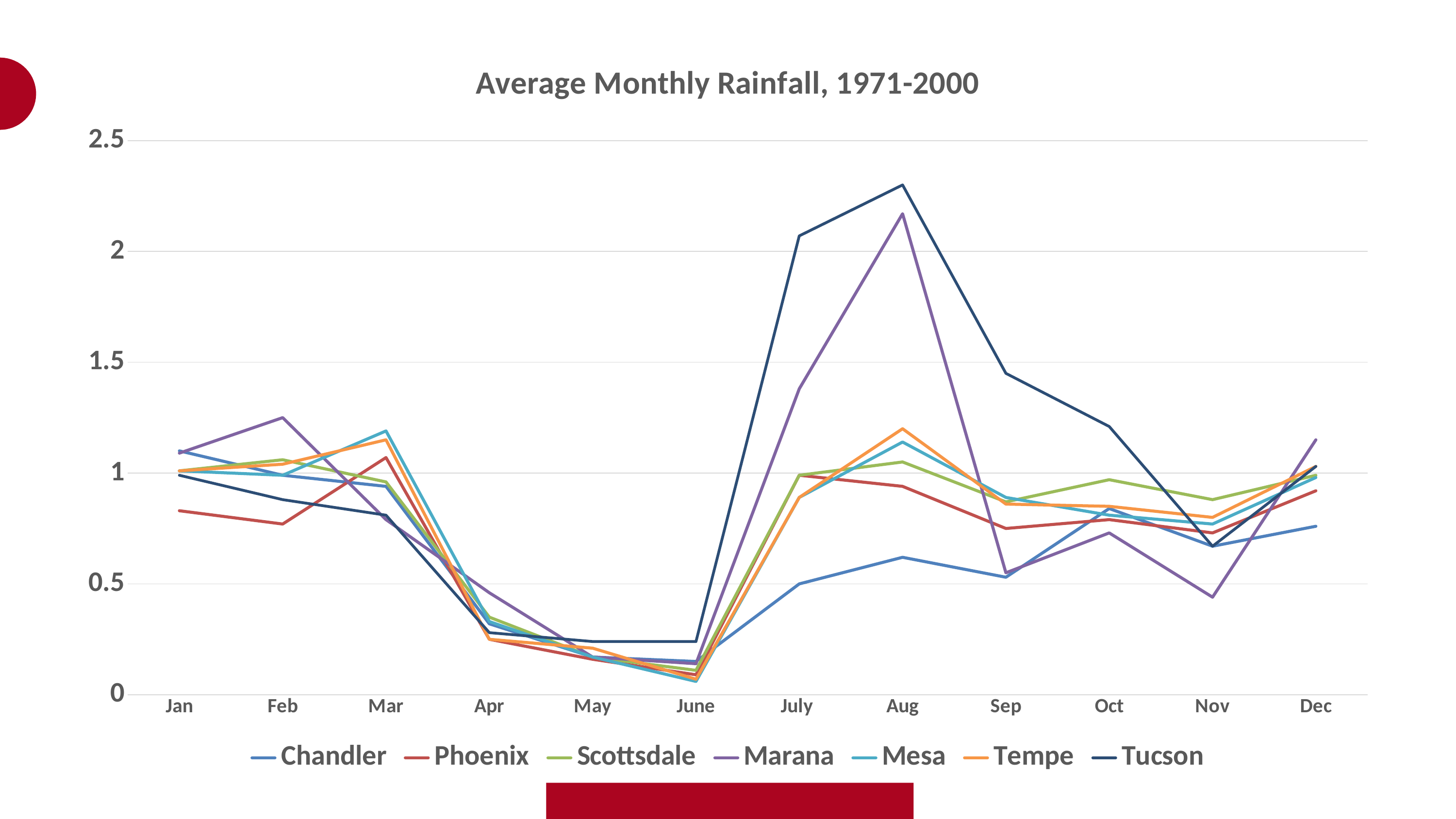
Is the value for Tucson in Aug greater or less than 2? greater Which series has the highest value in Aug? Tucson What kind of chart is shown on the slide? line chart In which month does Tucson reach its highest value? Aug How many months are plotted along the x axis? 12 In which month does Marana reach its highest value? Aug How many series does the legend list? 7 Which is larger in Nov, the value for Chandler or the value for Marana? Chandler Is the value for Marana in Nov greater or less than 0.5? less Does the Tucson line rise or fall from Aug to Dec? fall In which month does Chandler reach its lowest value? June What is the title of the chart? Average Monthly Rainfall, 1971-2000